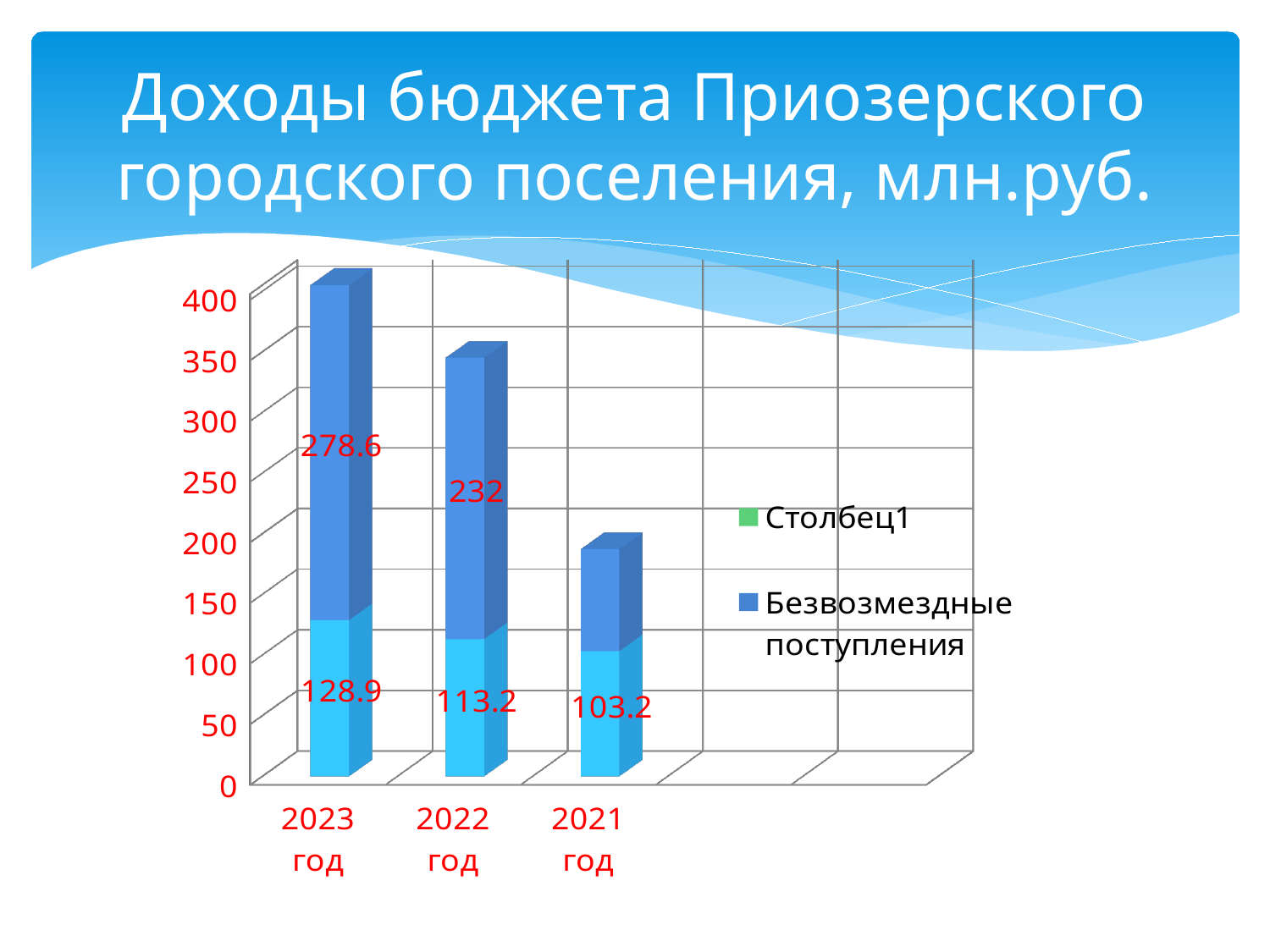
What is the value of the lower (light blue) segment for 2023 год? 128.9 Is the total height of the bar for 2021 год greater or less than 150? greater What is the value of Безвозмездные поступления for 2022 год? 232 What is the difference between Безвозмездные поступления in 2023 год and 2022 год? 46.6 What is the total of the stacked bar for 2023 год? 407.5 What is the value of the lower (light blue) segment for 2021 год? 103.2 Which year has the tallest stacked bar? 2023 год What is the value of Безвозмездные поступления for 2023 год? 278.6 What kind of chart is shown on the slide? Stacked bar chart How many years (categories) are shown on the x axis of the chart? 3 How many series does the chart legend list? 2 What is the title of the chart on the slide? Доходы бюджета Приозерского городского поселения, млн.руб.